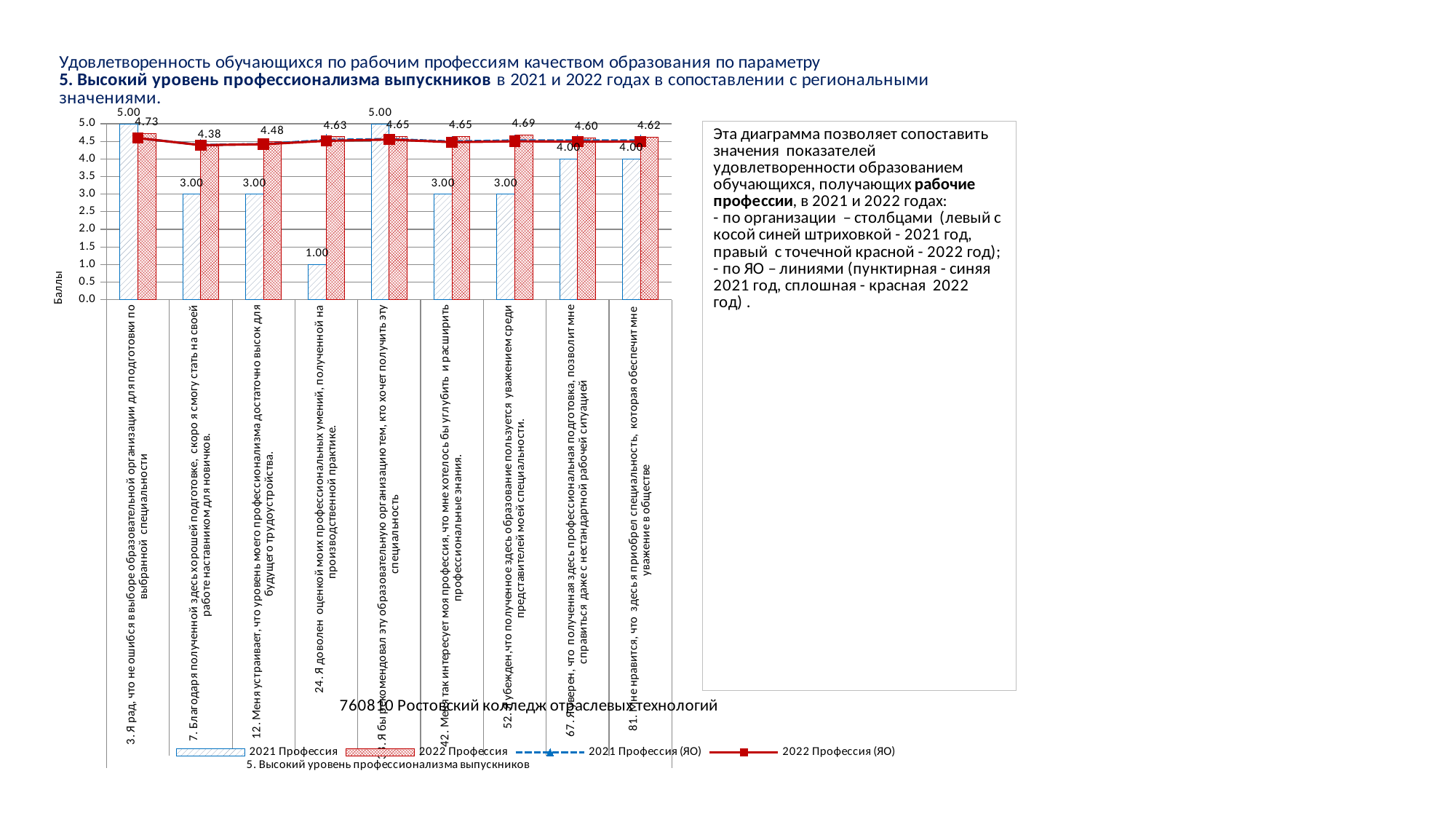
How many categories (survey statements) are plotted along the x axis? 9 Which legend entry is drawn as a solid red line with square markers? 2022 Профессия (ЯО) What is the title of the vertical axis? Баллы Which has the larger 2021 Профессия value: statement 67 or statement 7? statement 67 What is the 2021 Профессия value for statement 3 (Я рад, что не ошибся в выборе образовательной организации)? 5.00 What is the difference between the 2021 Профессия values for statement 3 and statement 24? 4.00 Is the 2021 Профессия value for statement 12 greater or less than 4.0? less How many series does the chart legend list? 4 What is the 2021 Профессия value for statement 24 (Я доволен оценкой моих профессиональных умений, полученной на производственной практике)? 1.00 What kind of chart is shown on the slide? bar chart with line series Which statement has the lowest 2021 Профессия value? 24. Я доволен оценкой моих профессиональных умений, полученной на производственной практике What is the 2021 Профессия value for statement 67 (Я уверен, что полученная здесь профессиональная подготовка позволит мне справиться даже с нестандартной рабочей ситуацией)? 4.00